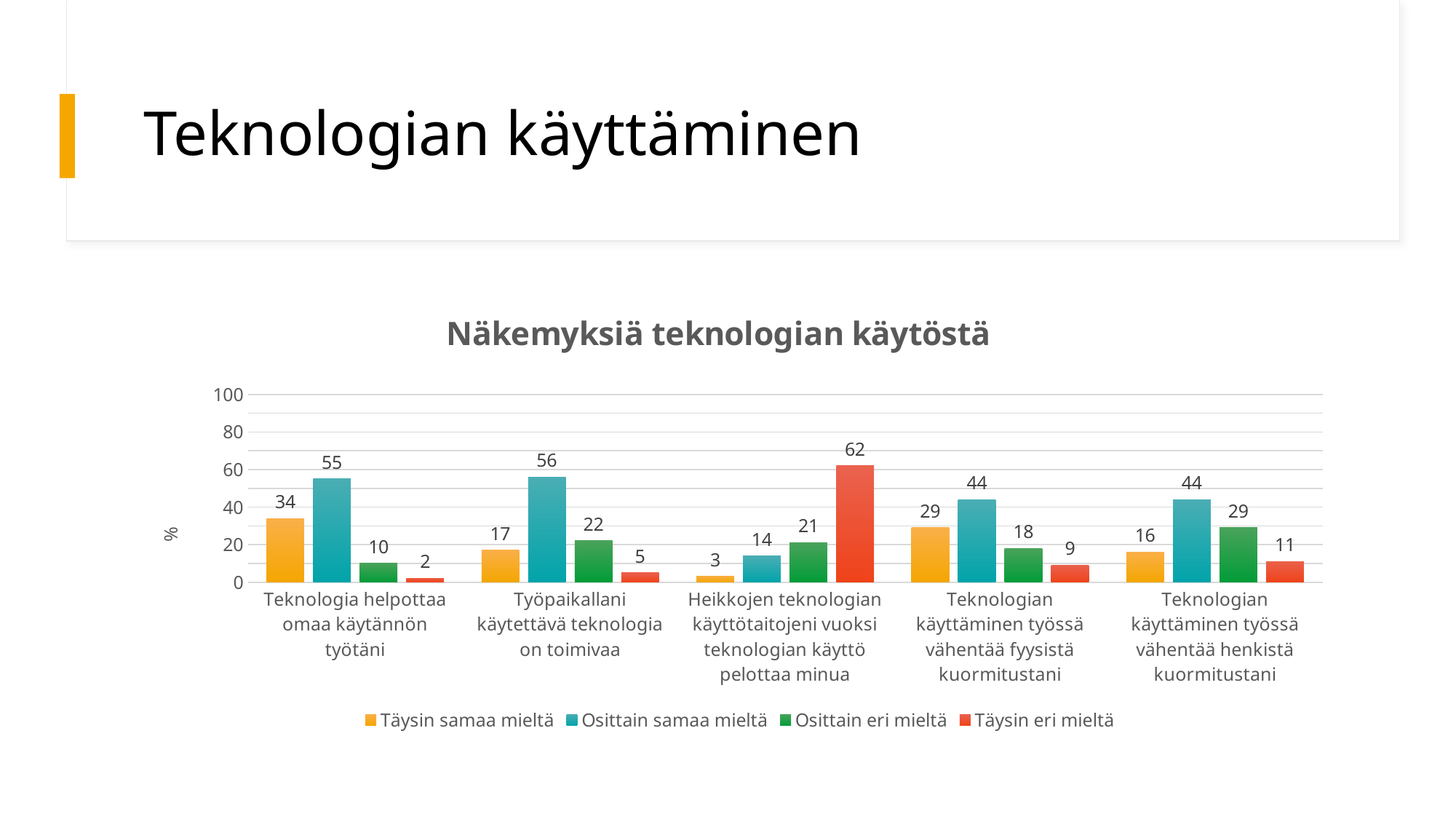
What is the value for "Osittain eri mieltä" in the category "Teknologian käyttäminen työssä vähentää henkistä kuormitustani"? 29 What is the value for "Täysin eri mieltä" in the category "Heikkojen teknologian käyttötaitojeni vuoksi teknologian käyttö pelottaa minua"? 62 What kind of chart is shown on the slide? Bar chart Which category has the lowest value for "Täysin samaa mieltä"? Heikkojen teknologian käyttötaitojeni vuoksi teknologian käyttö pelottaa minua What is the value for "Täysin samaa mieltä" in the category "Teknologia helpottaa omaa käytännön työtäni"? 34 How many categories are shown on the x axis? 5 What is the title of the chart? Näkemyksiä teknologian käytöstä Which is larger in the category "Teknologian käyttäminen työssä vähentää fyysistä kuormitustani": "Täysin samaa mieltä" or "Osittain eri mieltä"? Täysin samaa mieltä Which category has the highest value for "Osittain samaa mieltä"? Työpaikallani käytettävä teknologia on toimivaa How many series does the legend list? 4 Is the value for "Täysin eri mieltä" in the category "Heikkojen teknologian käyttötaitojeni vuoksi teknologian käyttö pelottaa minua" greater or less than 60? greater What is the difference between "Osittain samaa mieltä" and "Täysin samaa mieltä" in the category "Teknologia helpottaa omaa käytännön työtäni"? 21